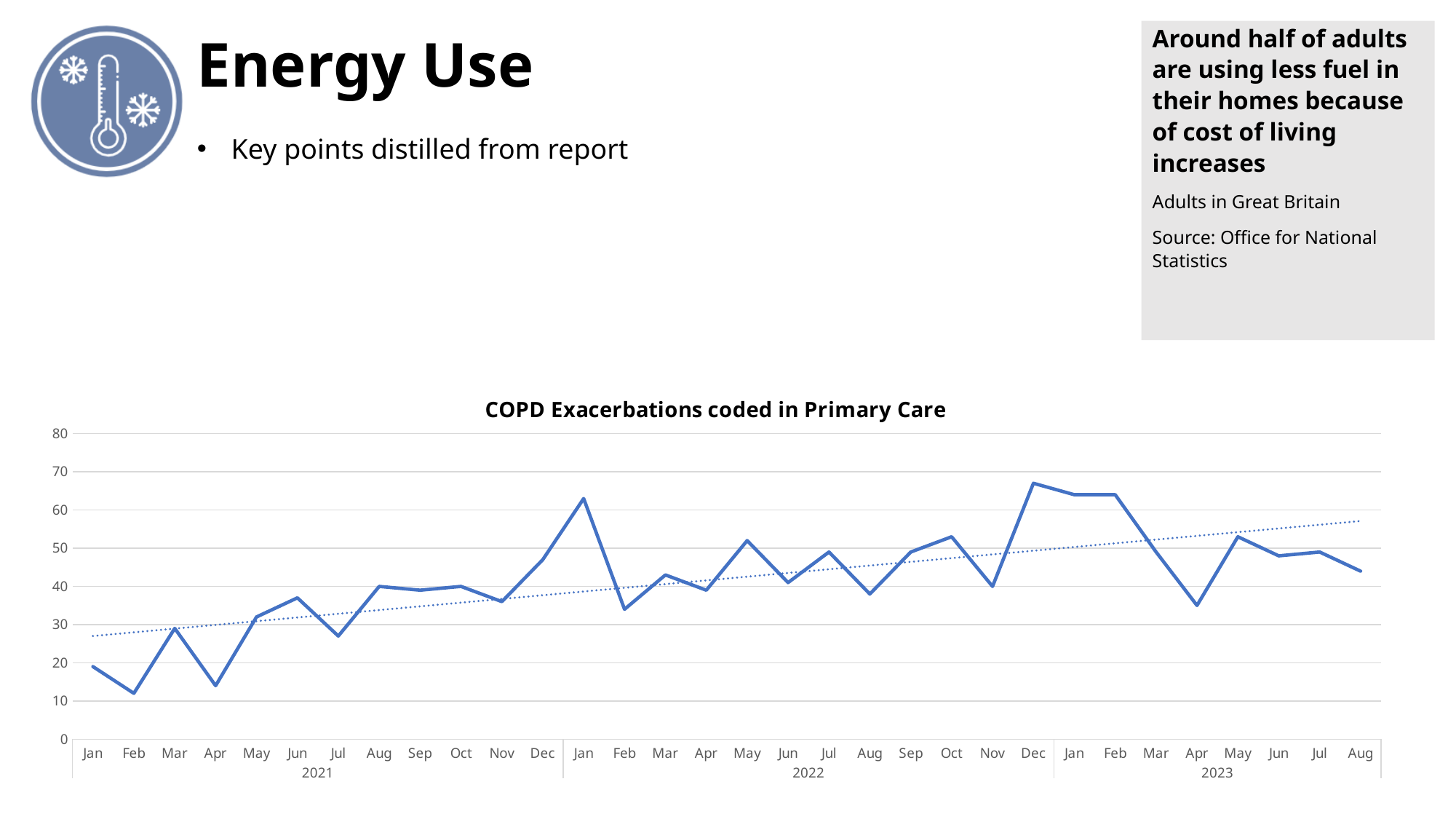
What kind of chart is the 'COPD Exacerbations coded in Primary Care' chart? line chart How many monthly data points are plotted in the COPD Exacerbations chart? 32 Is the value for Apr 2021 in the COPD Exacerbations chart greater or less than 20? less Is the value for Jan 2022 in the COPD Exacerbations chart greater or less than 60? greater Overall, do the values in the COPD Exacerbations chart rise or fall from Jan 2021 to Aug 2023? rise Which years are labelled along the x axis of the COPD Exacerbations chart? 2021, 2022, 2023 Is the value for Jul 2021 in the COPD Exacerbations chart greater or less than 30? less What is the title of the chart on the slide? COPD Exacerbations coded in Primary Care Which month has the highest value in the COPD Exacerbations chart? Dec 2022 In the COPD Exacerbations chart, which is larger: the value for Jan 2022 or Feb 2022? Jan 2022 Which month has the lowest value in the COPD Exacerbations chart? Feb 2021